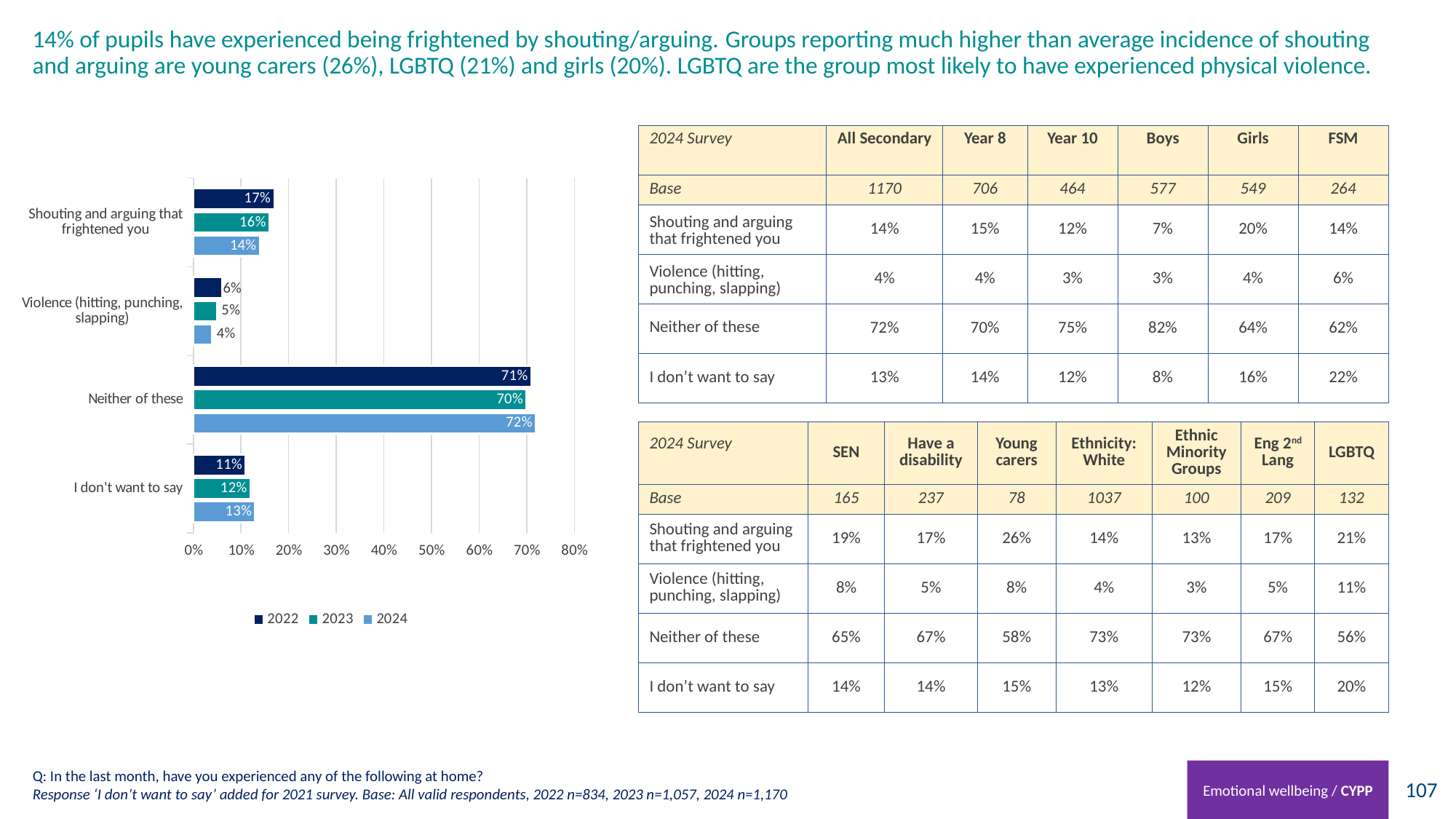
Which years are listed in the legend of the bar chart? 2022, 2023, 2024 What is the 2022 value for 'Shouting and arguing that frightened you' in the bar chart? 17% Which category has the lowest value for 2022 in the bar chart? Violence (hitting, punching, slapping) In the bar chart, is the 2024 value for 'I don't want to say' larger or smaller than the 2022 value for the same category? larger What is the 2023 value for 'Violence (hitting, punching, slapping)' in the bar chart? 5% What is the 2024 value for 'Neither of these' in the bar chart? 72% What is the difference between the 2022 and 2024 values for 'Shouting and arguing that frightened you' in the bar chart? 3% How many series does the legend of the bar chart list? 3 Is the 2023 value for 'Neither of these' in the bar chart greater or less than 60%? greater How many categories are shown on the bar chart? 4 Which category has the highest value for 2024 in the bar chart? Neither of these What kind of chart is shown on the slide? Bar chart